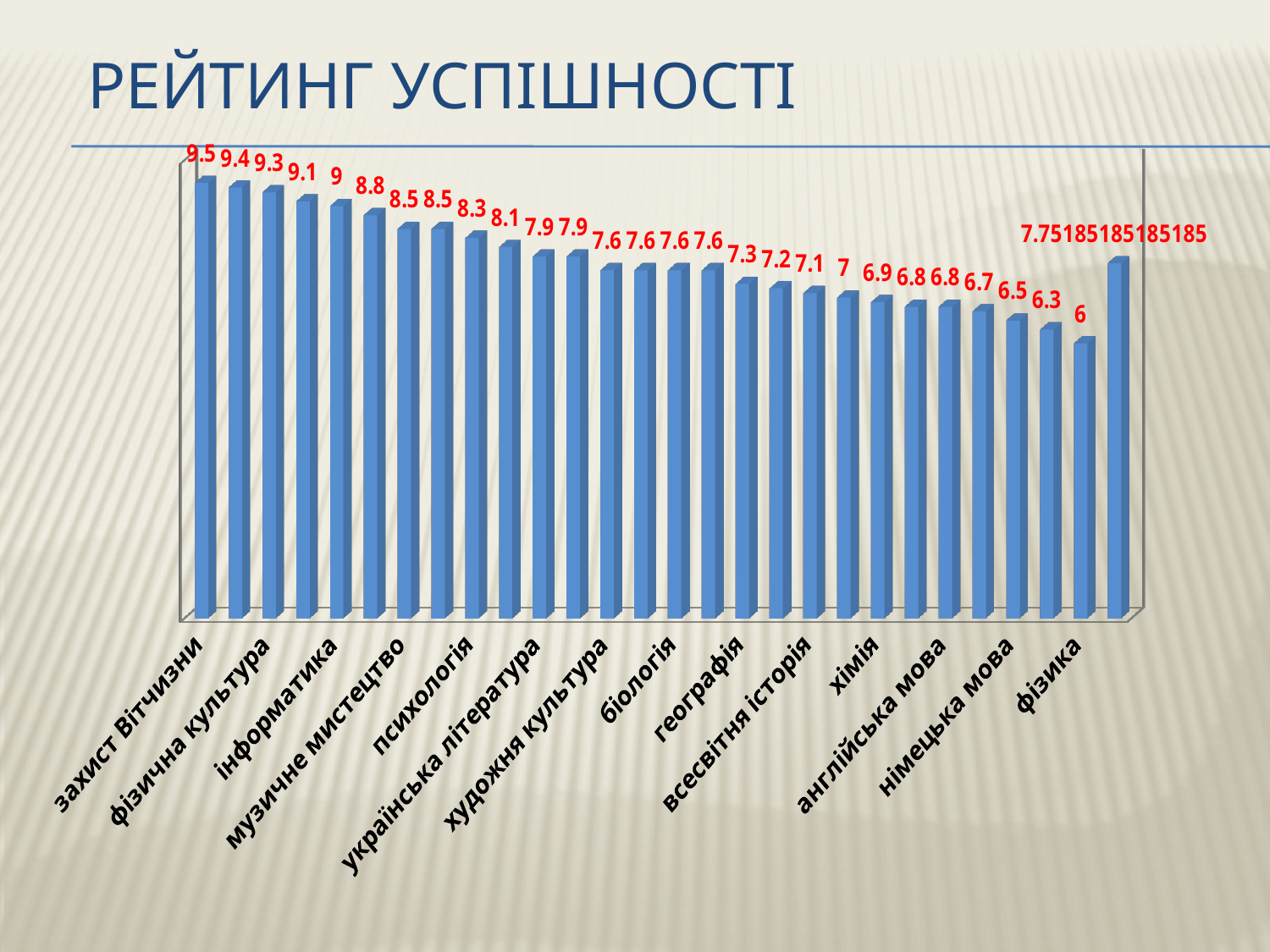
Which category has the highest value? захист Вітчизни What value is printed above the last (rightmost) bar? 7.75185185185185 Do the values generally rise or fall from left to right across the labelled subjects? fall What is the difference between the values for захист Вітчизни and фізика? 3.5 What is the title of the chart? РЕЙТИНГ УСПІШНОСТІ What colour are the bars in the chart? blue Which labelled category has the lowest value? фізика What kind of chart is shown on the slide? bar chart How many bars are plotted in the chart? 28 Which is larger, the value for захист Вітчизни or the value for фізика? захист Вітчизни What is the value for захист Вітчизни? 9.5 What is the value for фізика? 6